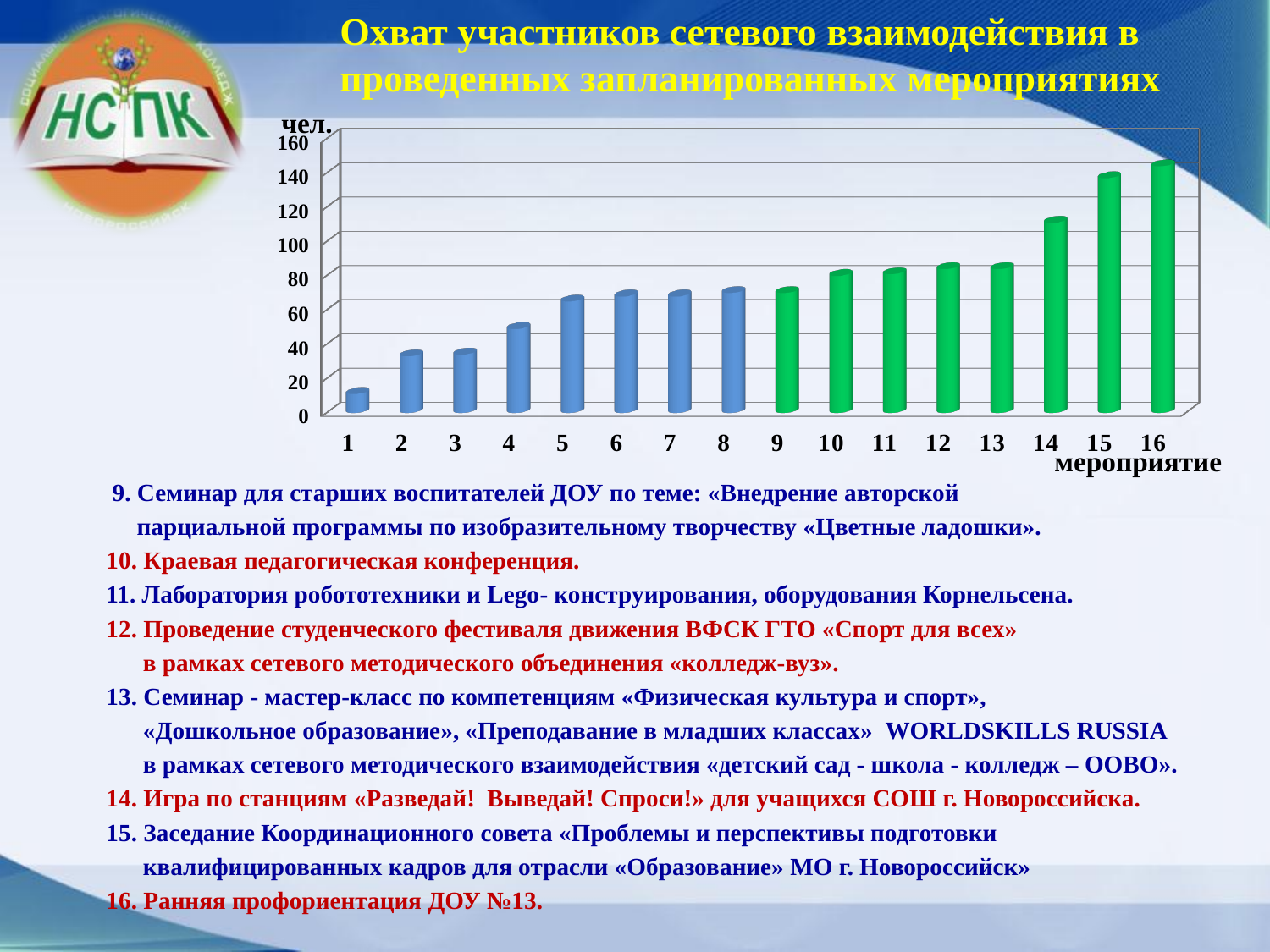
Which event number has the highest bar in the chart? 16 How many events (categories) are plotted on the x axis of the chart? 16 Which event number has the lowest bar in the chart? 1 Is the value for event 14 greater or less than 100? greater Is the value for event 1 greater or less than 20? less Is the value for event 4 greater or less than 60? less Which has the larger value, event 4 or event 5? event 5 What colour are the bars for events 9 to 16? green Which has the larger value, event 14 or event 15? event 15 Do the bar values generally rise or fall from event 1 to event 16? rise What kind of chart is shown on the slide? bar chart